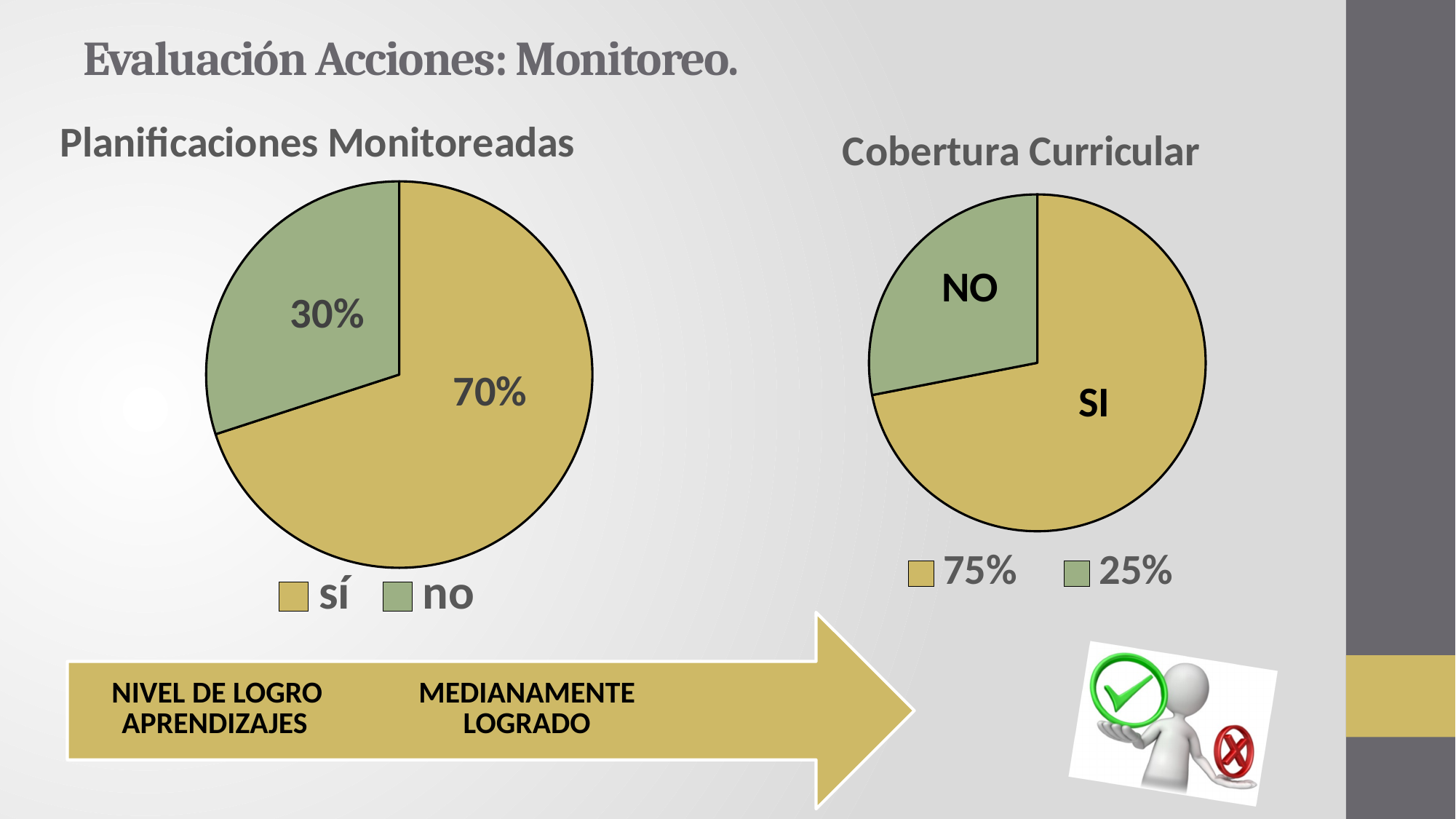
In the "Cobertura Curricular" chart, what is the difference between the "SI" and "NO" shares? 50% What kind of chart is the "Planificaciones Monitoreadas" chart? pie chart In the "Cobertura Curricular" chart, which slice is the smallest? NO How many slices does the "Planificaciones Monitoreadas" pie chart have? 2 In the "Cobertura Curricular" chart, what share does the "SI" slice represent? 75% In the "Planificaciones Monitoreadas" chart, which slice is the largest? sí In the "Planificaciones Monitoreadas" chart, what share is labelled "sí"? 70% How many entries does the legend of the "Cobertura Curricular" chart list? 2 Which is larger: the "sí" share in "Planificaciones Monitoreadas" or the "SI" share in "Cobertura Curricular"? SI in Cobertura Curricular In the "Planificaciones Monitoreadas" chart, what share is labelled "no"? 30% In the "Cobertura Curricular" chart, what share does the "NO" slice represent? 25% In the "Planificaciones Monitoreadas" chart, what is the difference between the "sí" and "no" shares? 40%